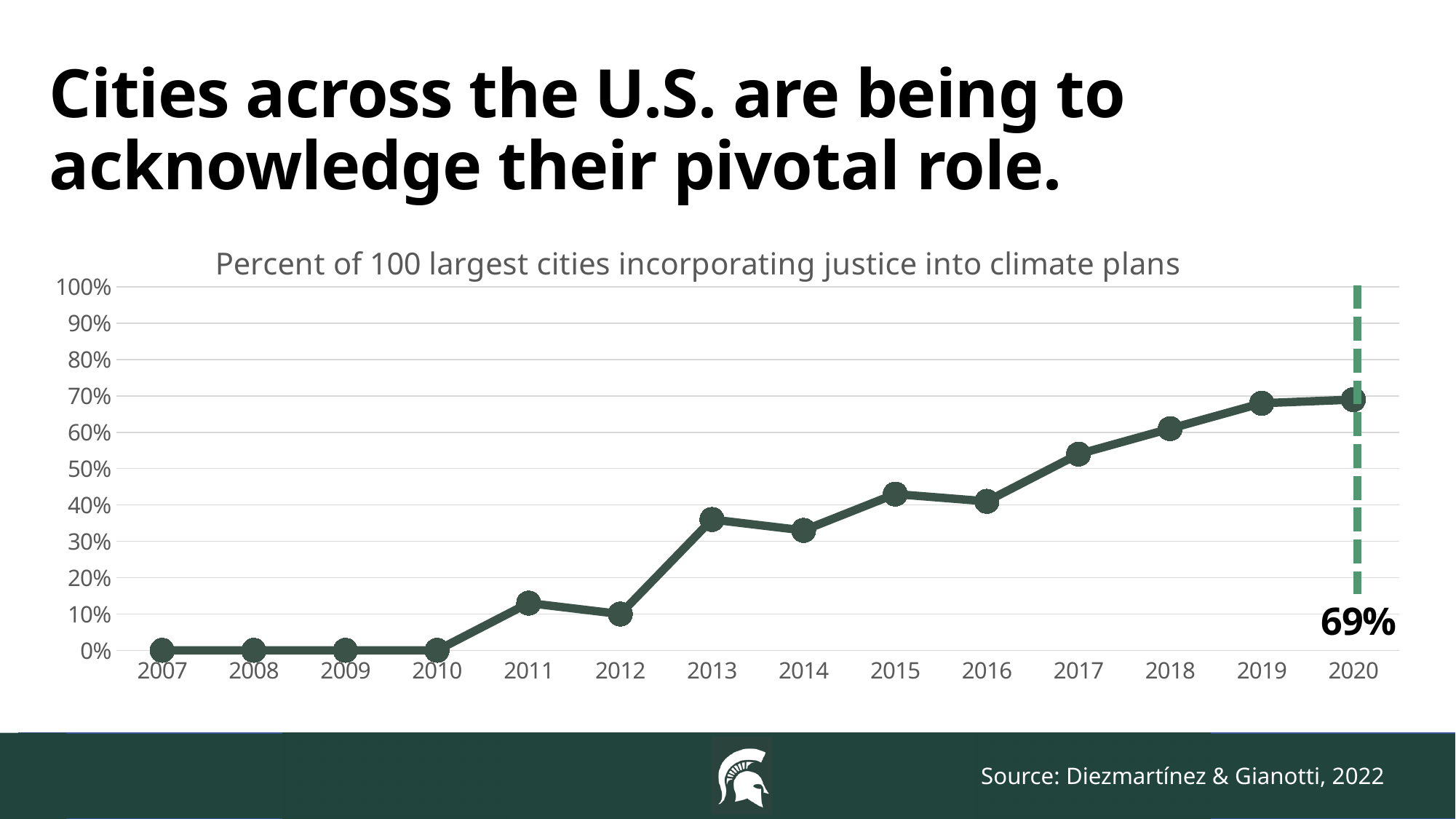
What is the difference between the value for 2020 and the value for 2007? 69 percentage points What kind of chart is shown on the slide? line chart Is the value for 2017 greater or less than 50%? greater What is the title of the chart? Percent of 100 largest cities incorporating justice into climate plans How many years show a value of 0%? 4 How many years are plotted on the x axis? 14 Which year has the larger value, 2012 or 2013? 2013 Do the values generally rise or fall from 2007 to 2020? rise Is the value for 2012 greater or less than 20%? less What is the value for 2007? 0% Is the value for 2013 greater or less than 30%? greater What is the value for 2020? 69%